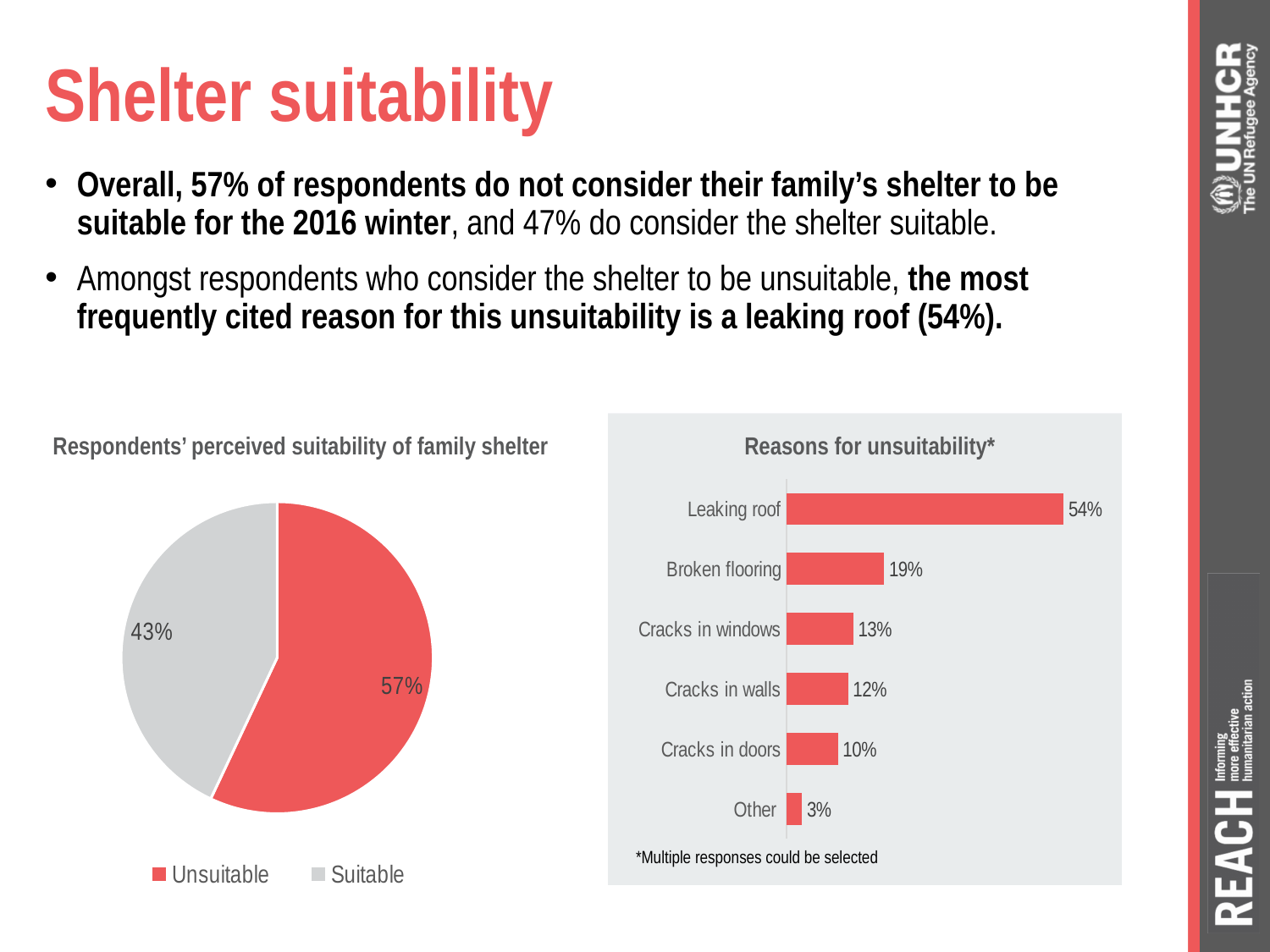
In the 'Respondents' perceived suitability of family shelter' chart, what share of respondents consider their shelter unsuitable? 57% In the 'Reasons for unsuitability' chart, what is the difference between Leaking roof and Broken flooring? 35% In the 'Reasons for unsuitability' chart, how many reasons are shown? 6 In the 'Respondents' perceived suitability of family shelter' chart, which colour represents 'Unsuitable'? Red In the 'Respondents' perceived suitability of family shelter' chart, how many entries does the legend list? 2 What kind of chart is 'Respondents' perceived suitability of family shelter'? Pie chart In the 'Reasons for unsuitability' chart, what is the value for Cracks in walls? 12% In the 'Respondents' perceived suitability of family shelter' chart, what share of respondents consider their shelter suitable? 43% In the 'Reasons for unsuitability' chart, what is the value for Leaking roof? 54% What kind of chart is 'Reasons for unsuitability'? Bar chart In the 'Reasons for unsuitability' chart, which reason has the lowest value? Other In the 'Reasons for unsuitability' chart, which reason has the highest value? Leaking roof